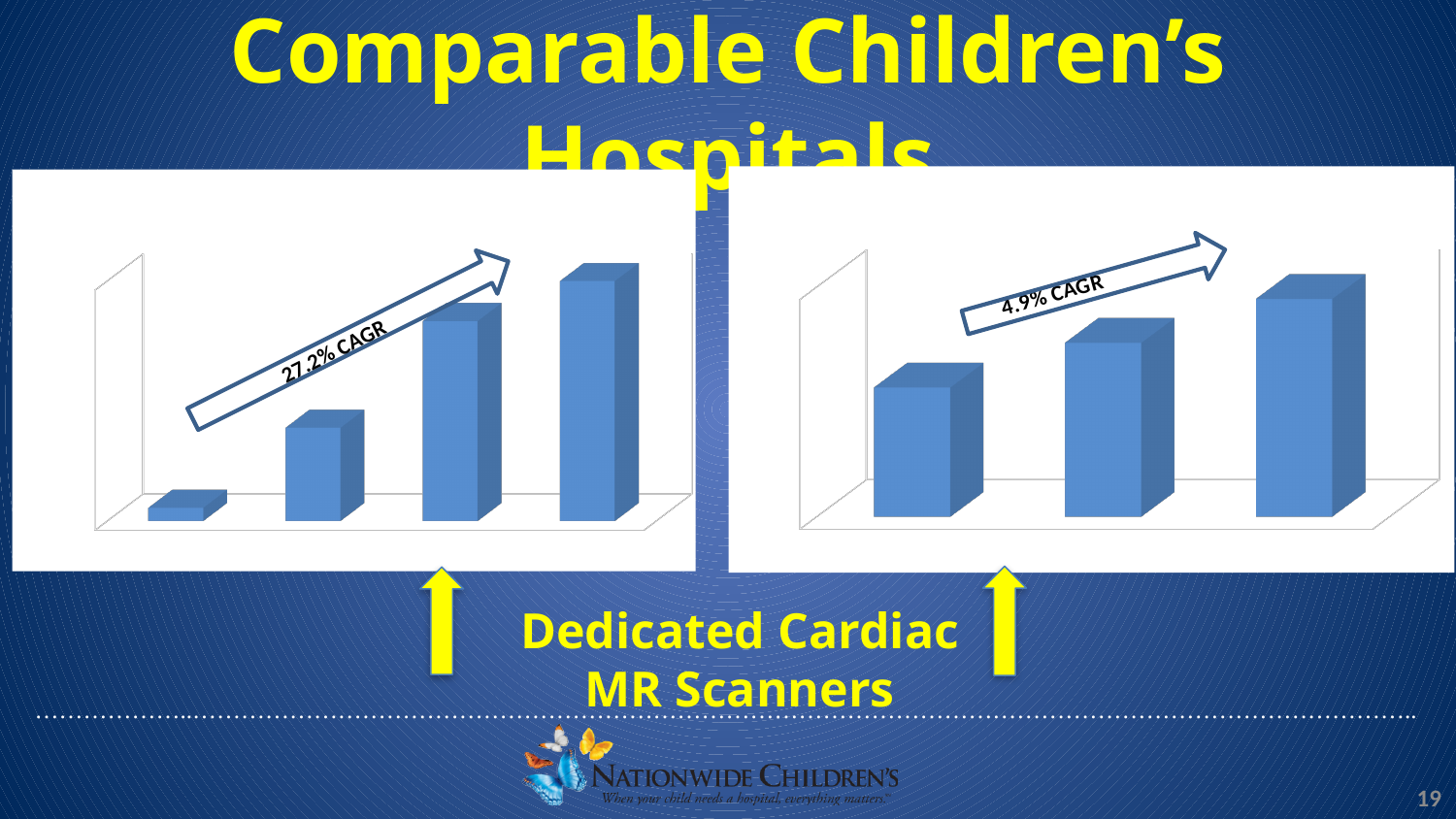
In the right chart, which bar is the tallest? the rightmost (third) bar What CAGR is annotated on the right chart? 4.9% CAGR In the right chart, do the bar values rise or fall from left to right? rise What kind of chart is the left chart on the slide? bar chart What kind of chart is the right chart on the slide? bar chart How many bars are plotted in the left chart? 4 In the left chart, which bar is the shortest? the leftmost (first) bar What CAGR is annotated on the left chart? 27.2% CAGR How many bars are plotted in the right chart? 3 In the right chart, which bar is the shortest? the leftmost (first) bar In the left chart, which bar is the tallest? the rightmost (fourth) bar In the left chart, do the bar values rise or fall from left to right? rise